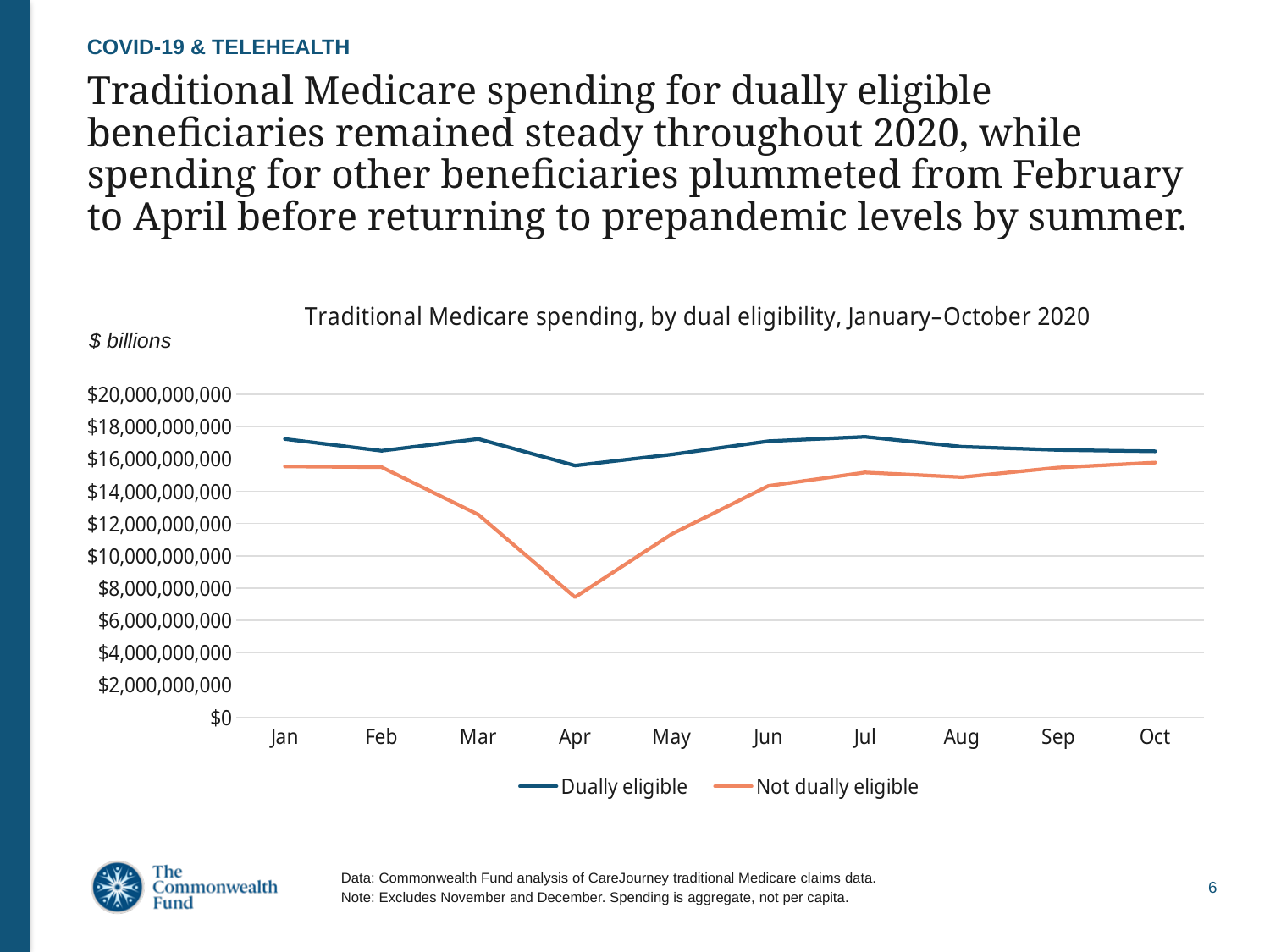
How many series does the legend list? 2 In which month is the Not dually eligible series at its lowest? Apr Is the value for Not dually eligible in Mar greater or less than $14,000,000,000? less Is the value for Not dually eligible in Apr greater or less than $8,000,000,000? less What kind of chart is shown on the slide? Line chart What is the title of the chart? Traditional Medicare spending, by dual eligibility, January–October 2020 Does the Not dually eligible series rise or fall from Feb to Apr? Fall In which month is the Dually eligible series at its lowest? Apr Does the Not dually eligible series rise or fall from Apr to Jul? Rise Is the value for Dually eligible in Jan greater or less than $16,000,000,000? greater In Apr, which series has the larger value, Dually eligible or Not dually eligible? Dually eligible How many months are plotted along the x axis? 10